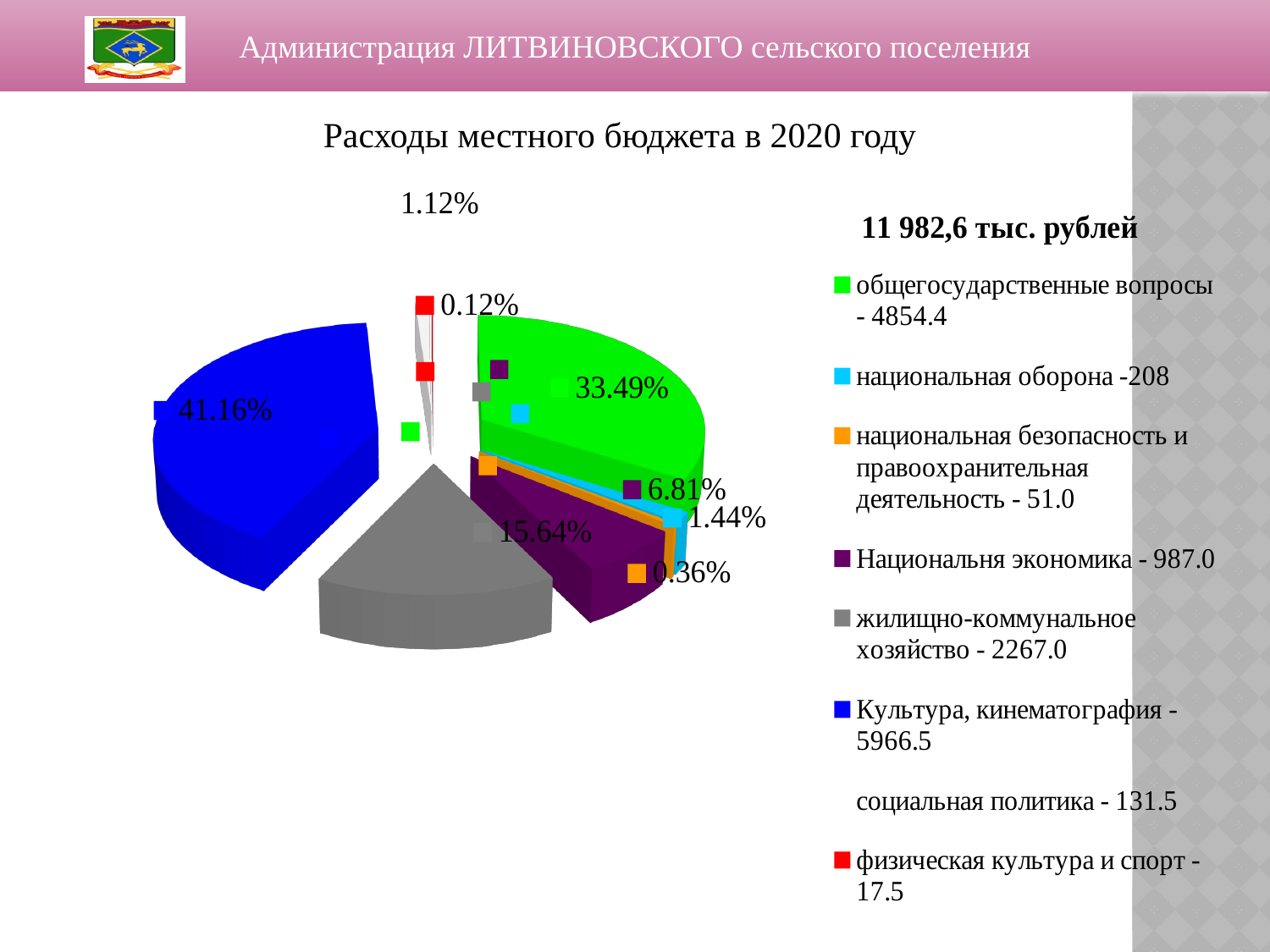
Which category has the largest share of the pie? Культура, кинематография What share of the pie is labelled for жилищно-коммунальное хозяйство? 15.64% What is the title of the chart? Расходы местного бюджета в 2020 году Which is larger: the share for Национальня экономика or the share for национальная оборона? Национальня экономика What share of the pie is labelled for общегосударственные вопросы? 33.49% Which category has the smallest share of the pie? физическая культура и спорт What total amount is stated next to the chart? 11 982,6 тыс. рублей How many categories does the legend list? 8 What value does the legend give for социальная политика? 131.5 What kind of chart is shown on the slide? pie chart What value does the legend give for национальная оборона? 208 What is the difference in percentage points between the largest slice (41.16%) and the second largest slice (33.49%)? 7.67